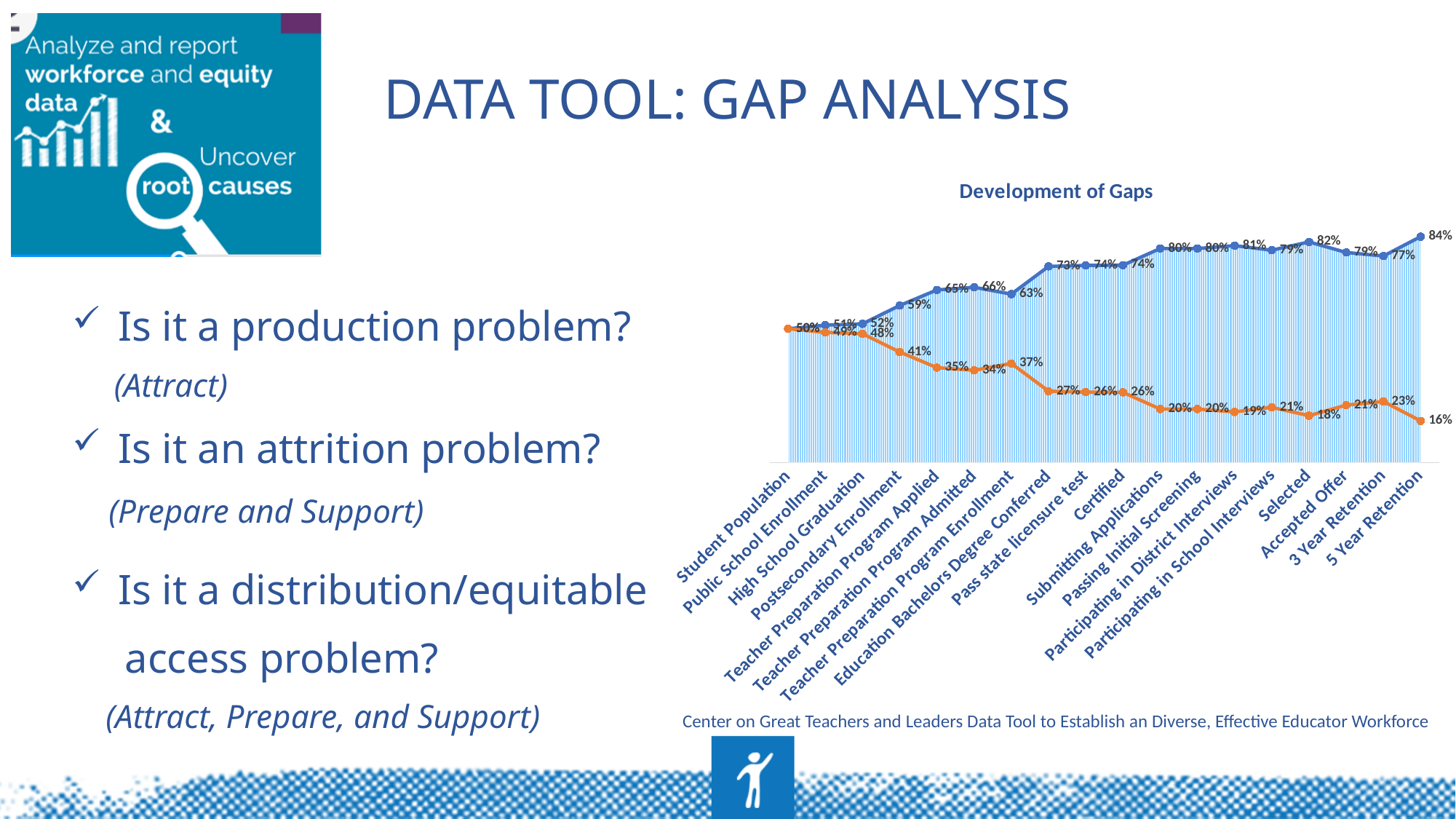
What is the value of the blue line at 5 Year Retention? 84% What is the difference between the blue line and the orange line at Selected? 64% Which is larger at Certified: the blue line value or the orange line value? the blue line What kind of chart is shown on the slide? combination area and line chart At which category does the orange line reach its lowest value? 5 Year Retention What is the title of the chart on the slide? Development of Gaps What is the value of the orange line at Postsecondary Enrollment? 41% At which category does the blue line reach its highest value? 5 Year Retention What is the value of the orange line at 5 Year Retention? 16% Does the orange line generally rise or fall from Student Population to 5 Year Retention? fall How many categories are shown along the x axis of the chart? 18 What is the value of the blue line at Education Bachelors Degree Conferred? 73%